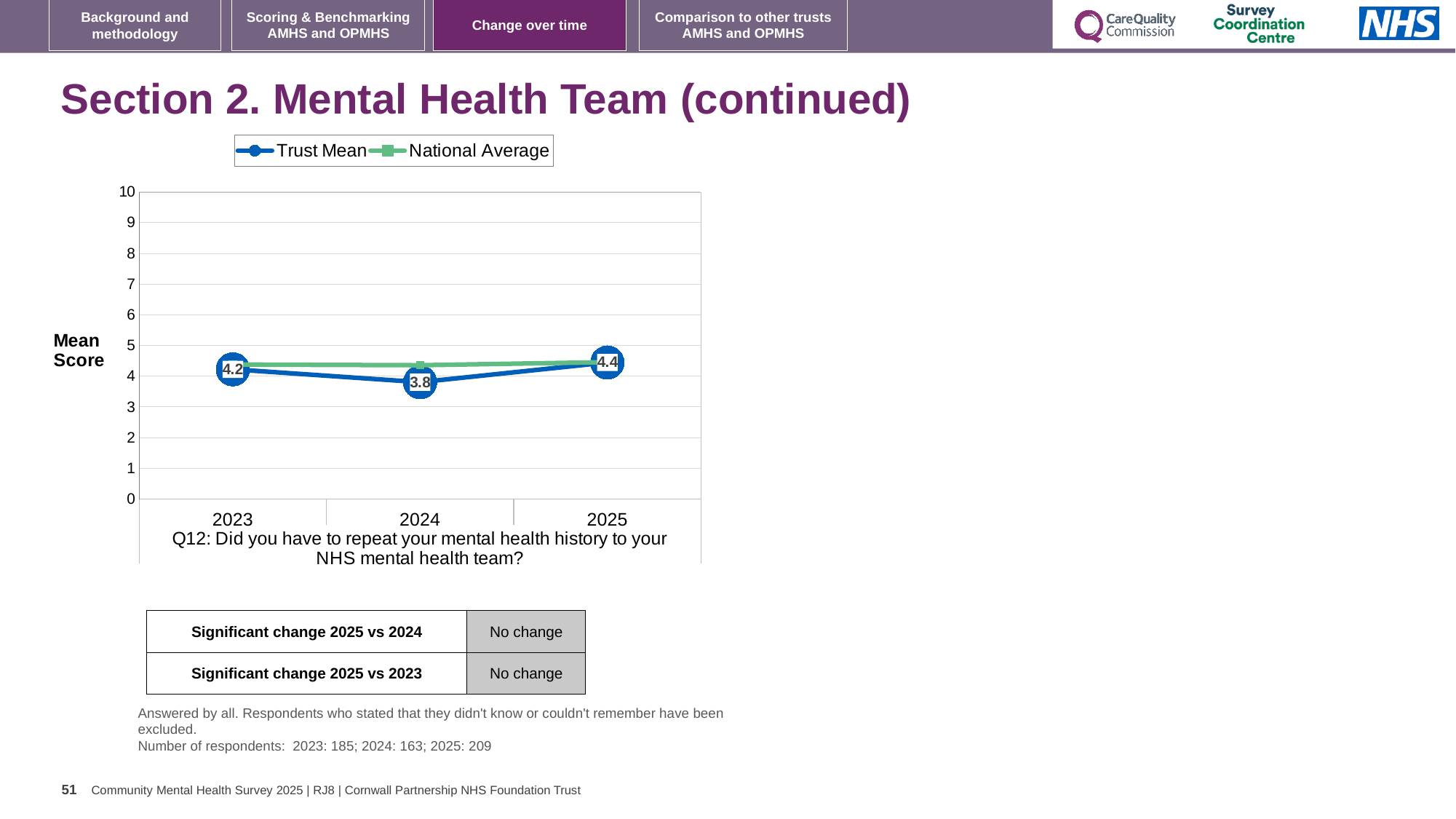
In which year is the Trust Mean lowest? 2024 What kind of chart is shown on the slide? Line chart Which year has the larger Trust Mean, 2023 or 2025? 2025 What is the Trust Mean score for 2025? 4.4 Between 2024 and 2025, does the Trust Mean rise or fall? Rise In which year is the Trust Mean highest? 2025 How many series does the legend list? 2 Is the National Average value for 2024 greater or less than 5? less What is the difference between the Trust Mean in 2025 and in 2024? 0.6 What is the Trust Mean score for 2024? 3.8 How many years are plotted on the x axis? 3 What is the Trust Mean score for 2023? 4.2